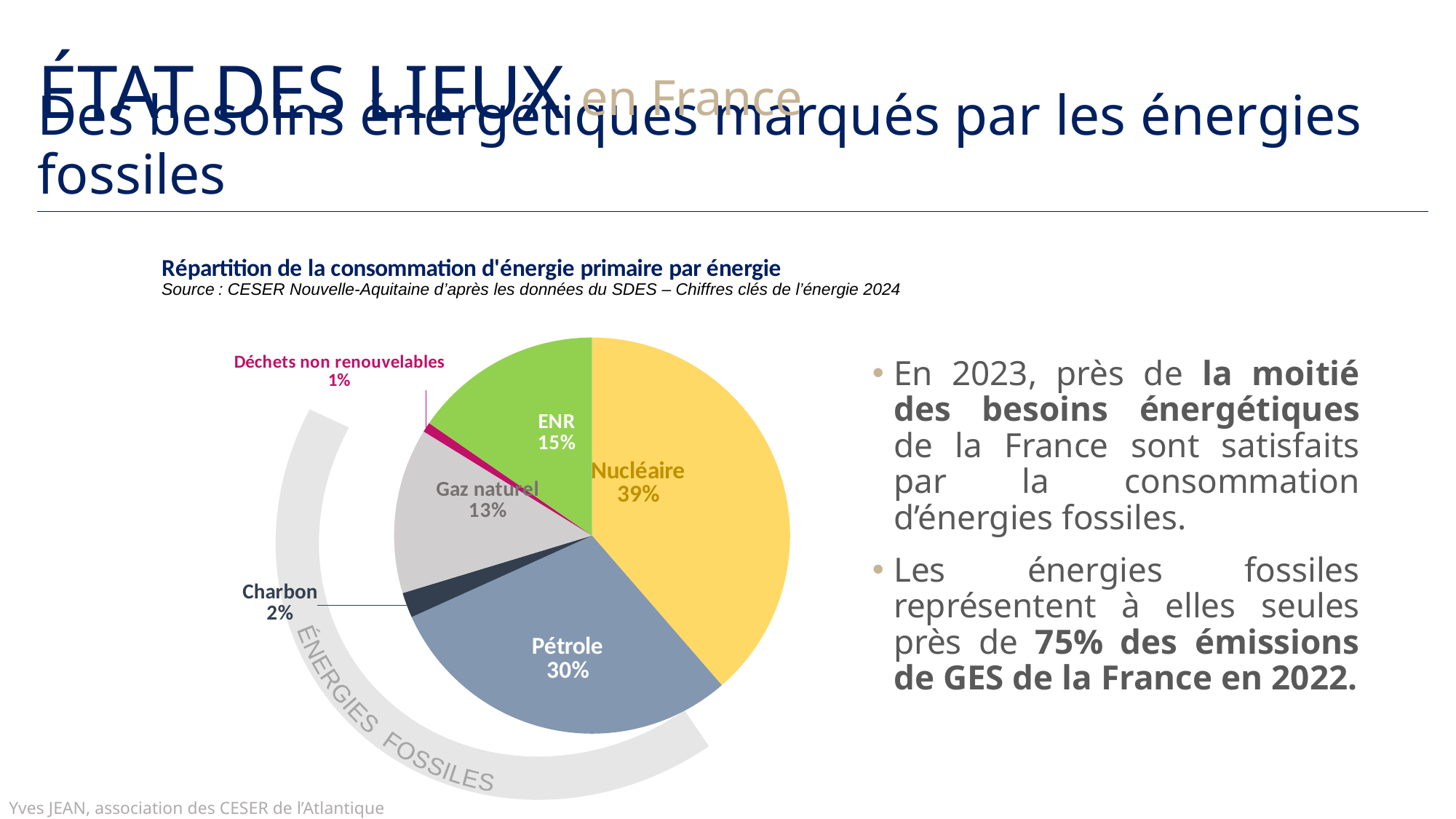
What is the value shown for Pétrole? 30% What is the value for Déchets non renouvelables? 1% How many slices does the pie chart have? 6 What is the difference in percentage points between Nucléaire and Pétrole? 9 Which energy source has the largest slice of the pie? Nucléaire Which energy source has the smallest slice of the pie? Déchets non renouvelables What is the title of the chart? Répartition de la consommation d'énergie primaire par énergie What percentage is shown for Gaz naturel? 13% What kind of chart is shown on the slide? pie chart What share of primary energy consumption does Nucléaire account for? 39% Which is larger, ENR or Gaz naturel? ENR What is the combined share of Pétrole, Gaz naturel and Charbon? 45%